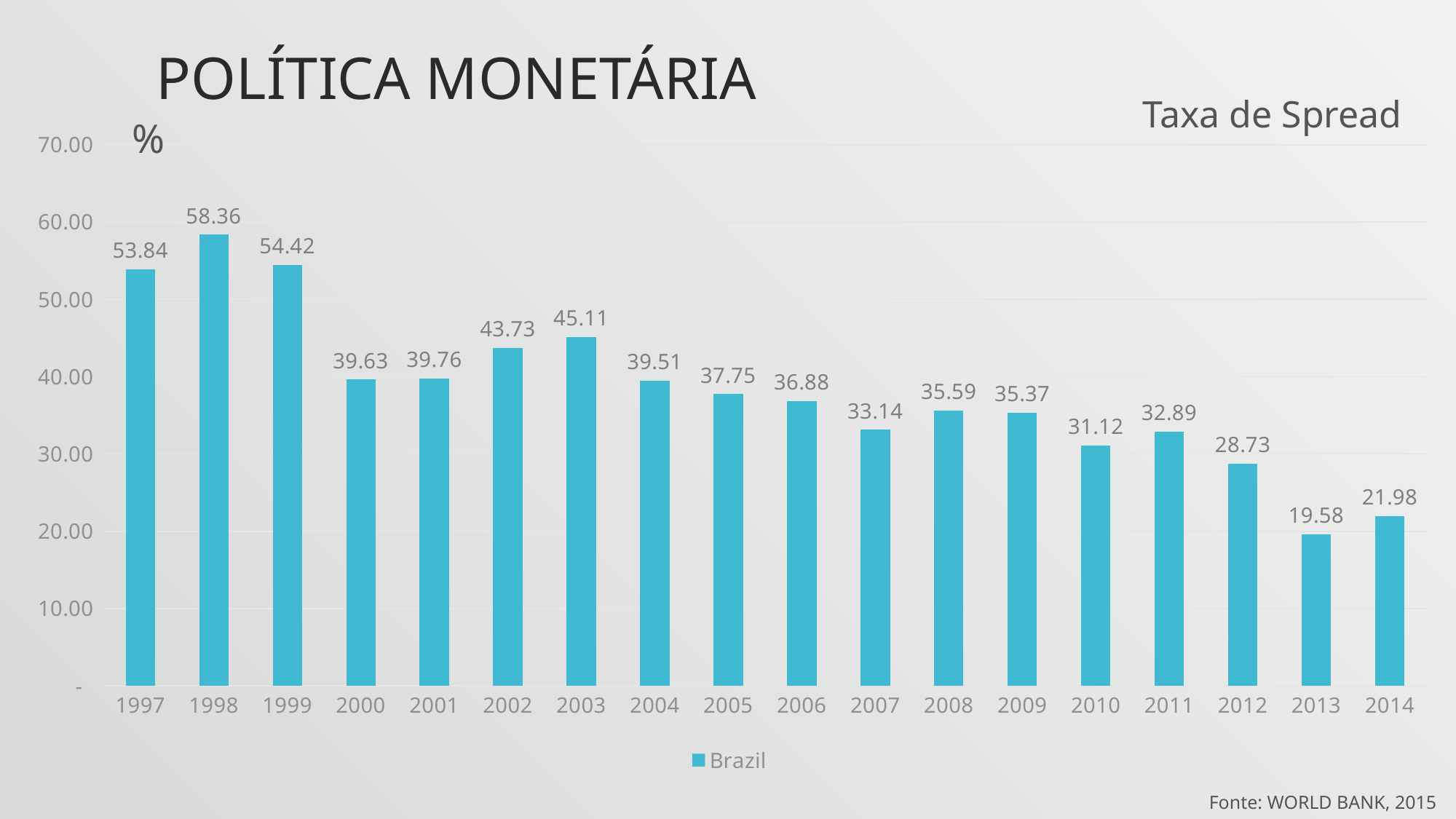
What is the value for 2007? 33.14 Which year has the highest value? 1998 Do the values generally rise or fall from 1997 to 2014? fall How many years are shown on the x axis? 18 Which is larger, the value for 2002 or the value for 2003? 2003 Is the value for 2010 greater or less than 30.00? greater What is the value for 2014? 21.98 Which year has the lowest value? 2013 How many series does the legend list? 1 What kind of chart is shown? bar chart What is the difference between the values for 1998 and 2013? 38.78 What is the value for 1998? 58.36